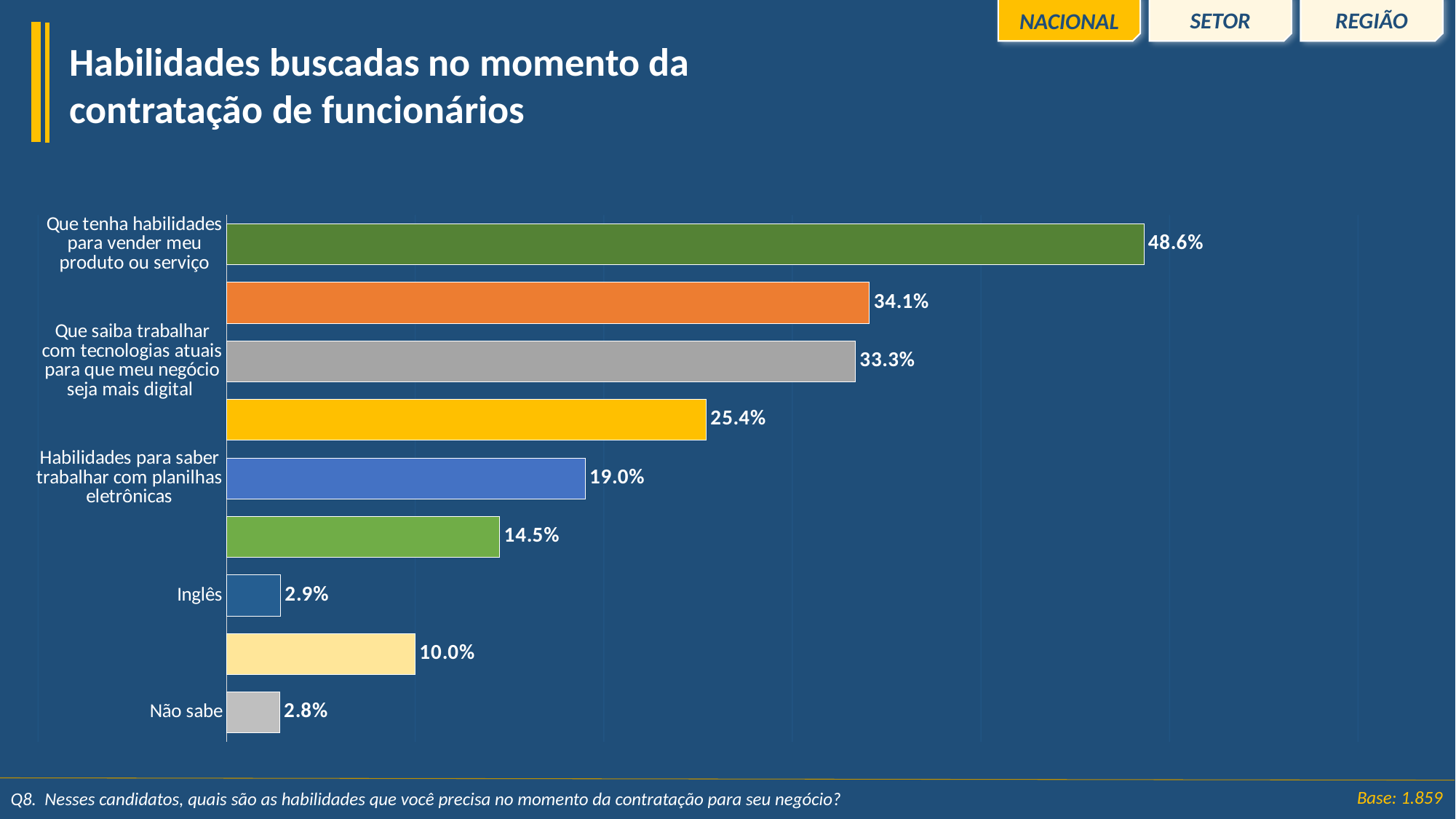
Which category has the highest value? Que tenha habilidades para vender meu produto ou serviço How many bars are plotted in the chart? 9 What is the title of the slide? Habilidades buscadas no momento da contratação de funcionários What kind of chart is shown on the slide? Bar chart What is the value for "Que saiba trabalhar com tecnologias atuais para que meu negócio seja mais digital"? 33.3% What is the value for "Habilidades para saber trabalhar com planilhas eletrônicas"? 19.0% What is the value for "Inglês"? 2.9% What is the difference between the values for "Que tenha habilidades para vender meu produto ou serviço" and "Que saiba trabalhar com tecnologias atuais para que meu negócio seja mais digital"? 15.3 percentage points What is the difference between the values for "Habilidades para saber trabalhar com planilhas eletrônicas" and "Inglês"? 16.1 percentage points What is the value for "Não sabe"? 2.8% What is the value for "Que tenha habilidades para vender meu produto ou serviço"? 48.6% Which is larger: the value for "Que saiba trabalhar com tecnologias atuais para que meu negócio seja mais digital" or the value for "Habilidades para saber trabalhar com planilhas eletrônicas"? Que saiba trabalhar com tecnologias atuais para que meu negócio seja mais digital